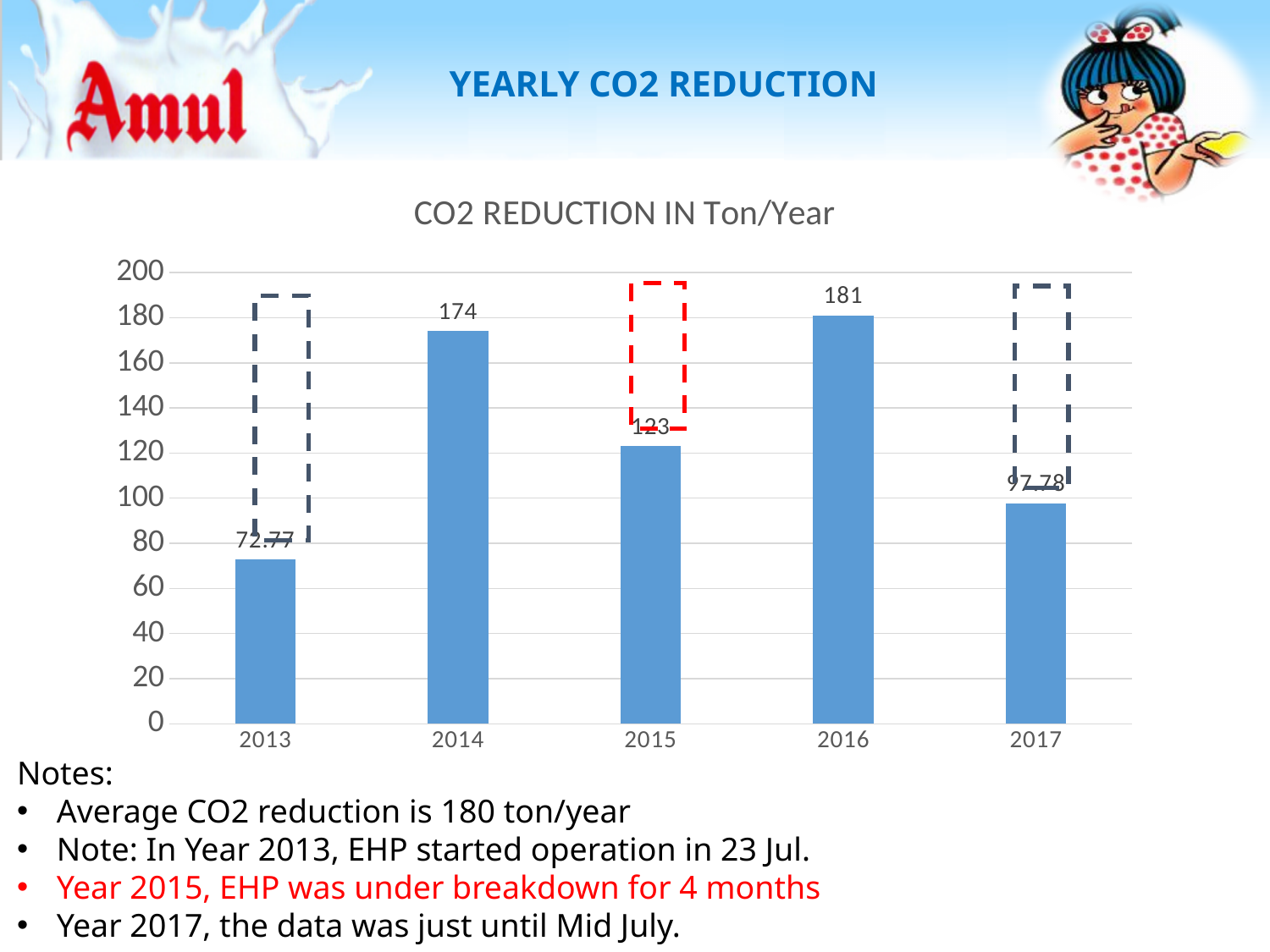
Which year has the highest CO2 reduction? 2016 What is the CO2 reduction value shown for 2015? 123 What is the CO2 reduction value shown for 2014? 174 What kind of chart is used to show the CO2 reduction? bar chart What is the CO2 reduction value shown for 2016? 181 Which year has the lowest CO2 reduction? 2013 Which year has a larger CO2 reduction, 2014 or 2017? 2014 How many years are shown on the x axis of the chart? 5 What is the difference between the CO2 reduction in 2016 and in 2015? 58 What is the CO2 reduction value shown for 2013? 72.77 What is the title of the chart? CO2 REDUCTION IN Ton/Year Is the value for 2017 greater or less than 100? less